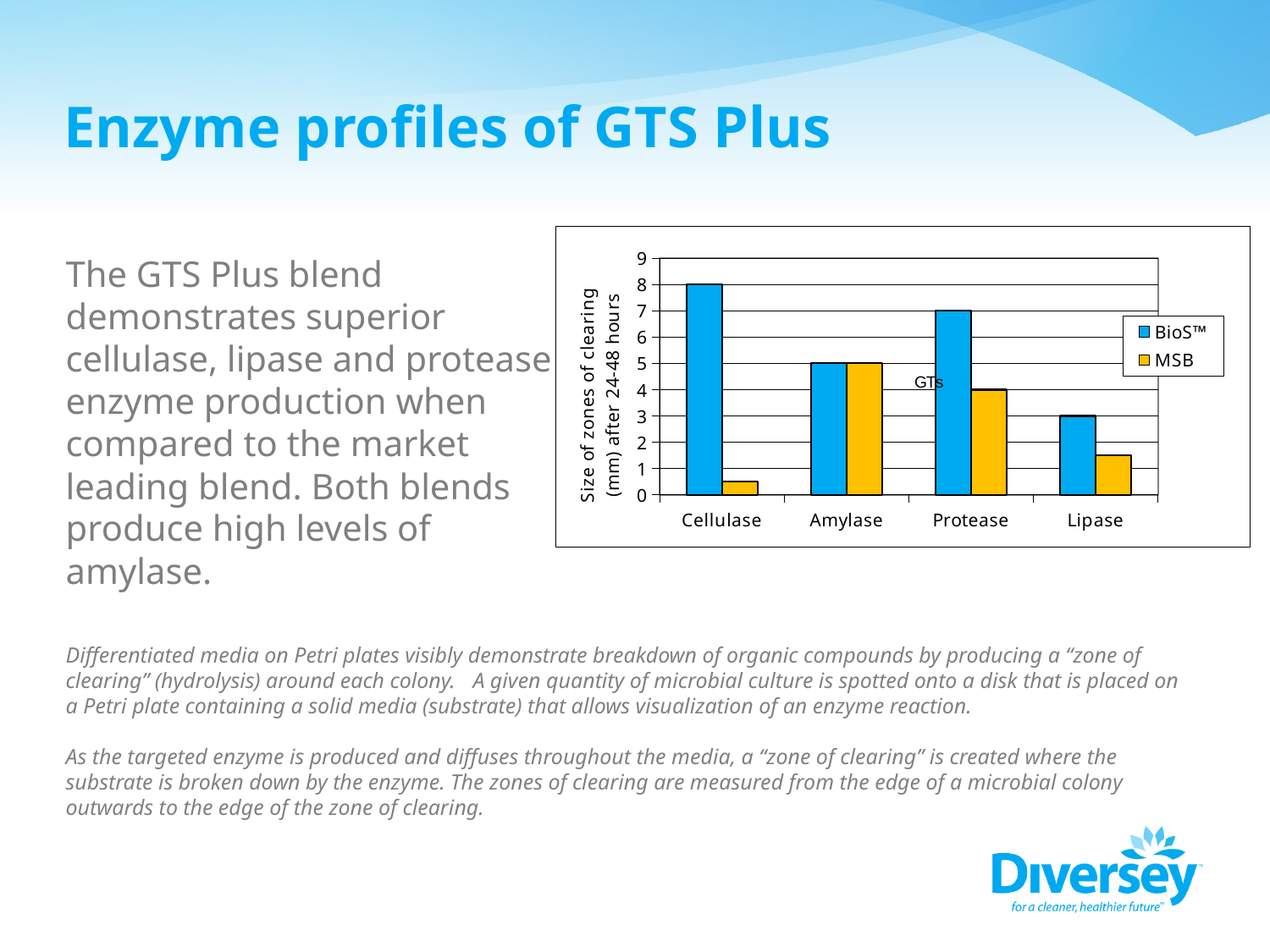
For which enzyme is the MSB value lowest? Cellulase What is the size of the zone of clearing for BioS™ on Protease? 7 How many series does the legend list? 2 For which enzyme is the BioS™ value highest? Cellulase What is the size of the zone of clearing for BioS™ on Cellulase? 8 What type of chart is shown on the slide? bar chart What is the size of the zone of clearing for MSB on Protease? 4 Which series has the larger value for Lipase, BioS™ or MSB? BioS™ Is the MSB value for Cellulase greater or less than 1? less How many enzyme categories are shown on the x axis? 4 What is the size of the zone of clearing for BioS™ on Lipase? 3 What is the difference between the BioS™ and MSB values for Protease? 3